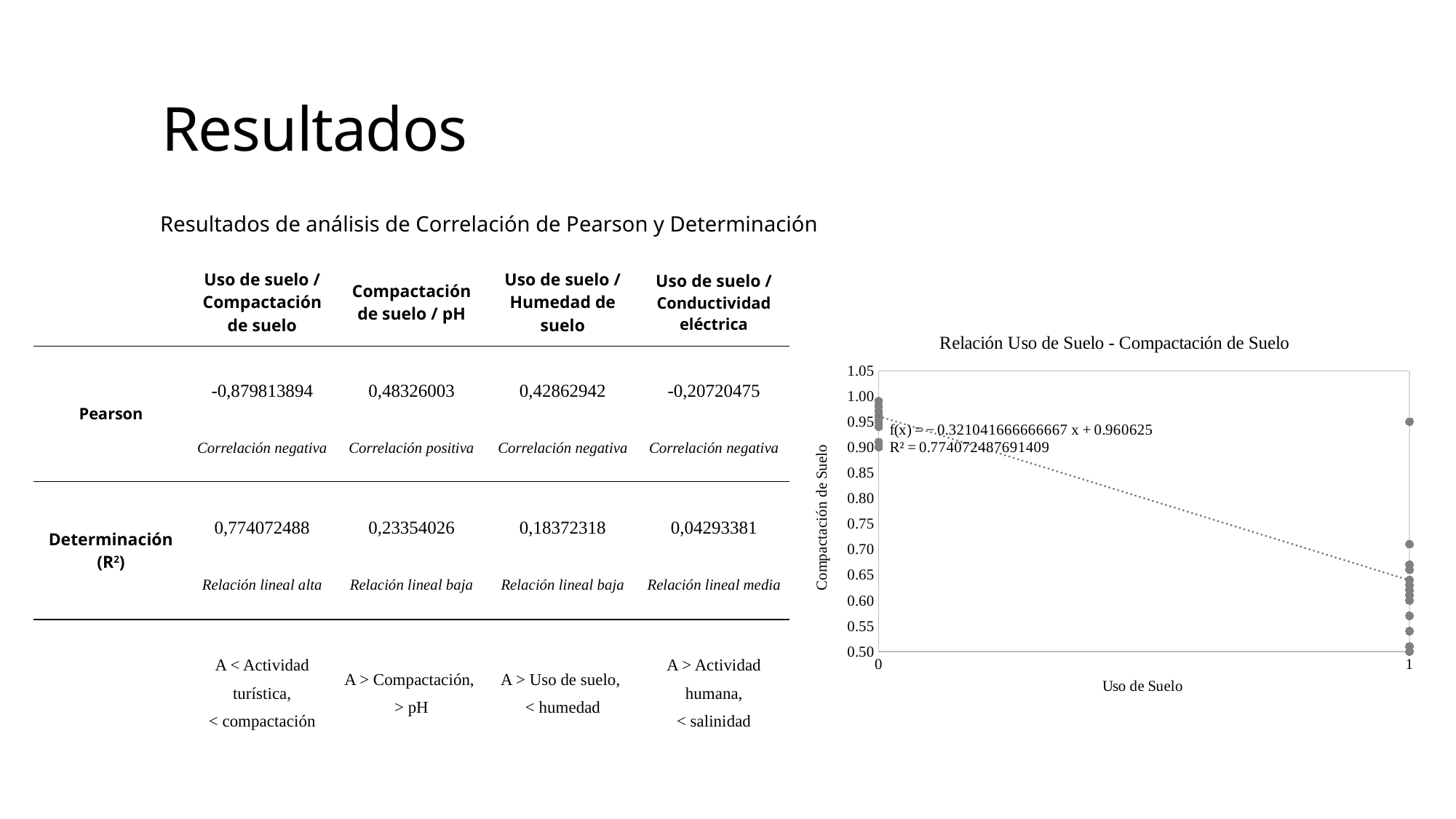
What is the lowest tick value shown on the vertical axis? 0.50 What is the label of the vertical axis of the chart? Compactación de Suelo Which x value has the higher cluster of Compactación de Suelo points, 0 or 1? 0 How many distinct x-axis values are the data points plotted at? 2 What is the highest tick value shown on the vertical axis? 1.05 Is the lowest data point at Uso de Suelo = 1 greater or less than 0.55? less Are the data points at Uso de Suelo = 0 greater or less than 0.85 on the vertical axis? greater What is the title of the chart? Relación Uso de Suelo - Compactación de Suelo What kind of chart is shown on the slide? Scatter chart What trendline equation is printed on the chart? f(x) = -0.321041666666667 x + 0.960625 Does the trendline rise or fall as Uso de Suelo increases from 0 to 1? Fall What R² value is printed on the chart? R² = 0.774072487691409